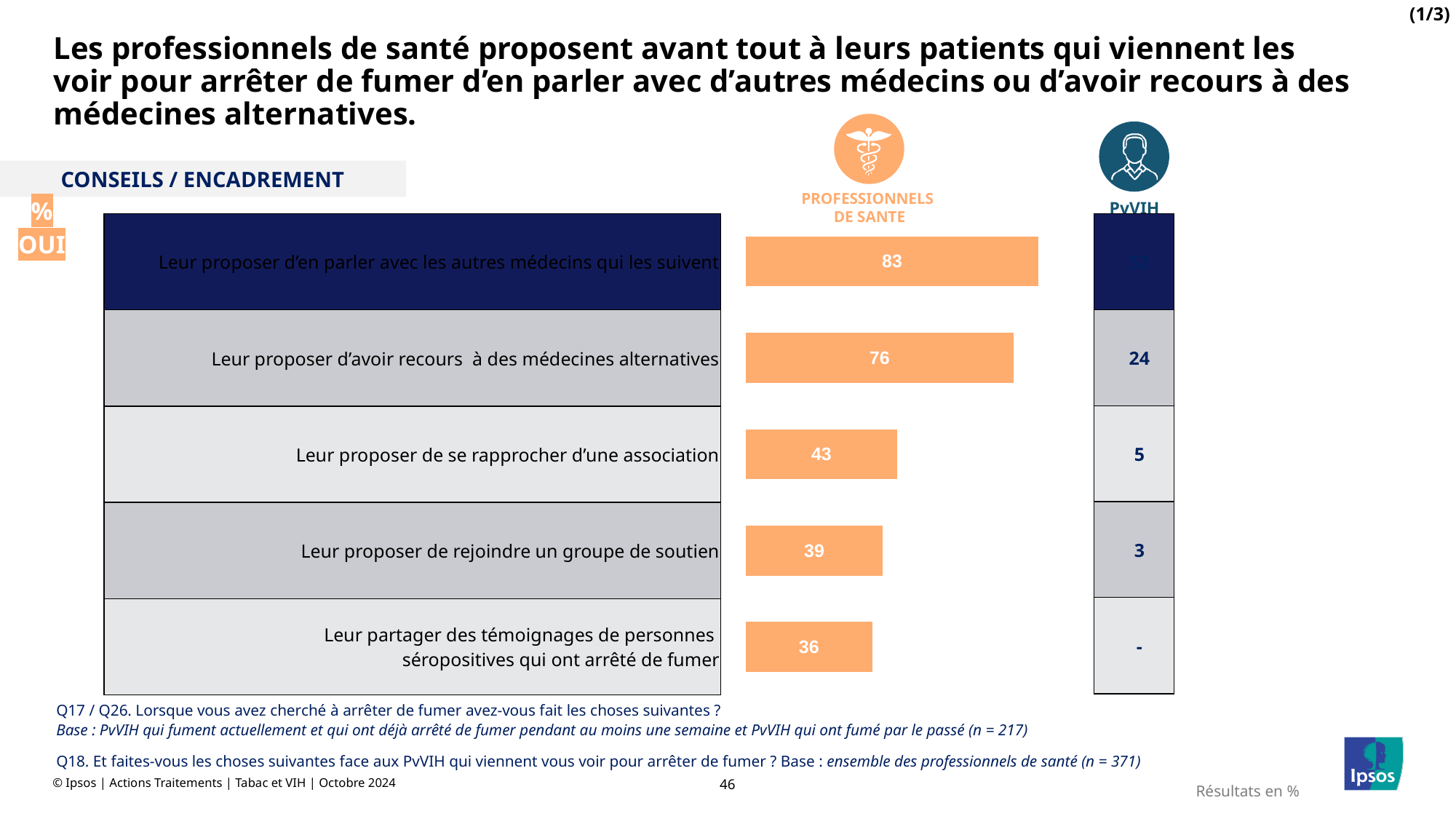
In the PvVIH column, what is the value for "Leur proposer d'avoir recours à des médecines alternatives"? 24 What is the difference between the health professionals' values for "Leur proposer d'en parler avec les autres médecins qui les suivent" and "Leur proposer d'avoir recours à des médecines alternatives"? 7 Which item has the highest value among health professionals? Leur proposer d'en parler avec les autres médecins qui les suivent What is the value for health professionals for "Leur proposer d'avoir recours à des médecines alternatives"? 76 In the PvVIH column, what is the value for "Leur proposer de rejoindre un groupe de soutien"? 3 Which item has the lowest value among health professionals? Leur partager des témoignages de personnes séropositives qui ont arrêté de fumer How many items (categories) are shown in the chart? 5 What is the value for health professionals for "Leur partager des témoignages de personnes séropositives qui ont arrêté de fumer"? 36 What type of chart is used to show the health professionals' results? Bar chart What percentage of health professionals (Professionnels de santé) propose to their patients to talk with the other doctors who follow them ("Leur proposer d'en parler avec les autres médecins qui les suivent")? 83 Among health professionals, which is larger: "Leur proposer de se rapprocher d'une association" or "Leur proposer de rejoindre un groupe de soutien"? Leur proposer de se rapprocher d'une association What is the value for health professionals for "Leur proposer de se rapprocher d'une association"? 43